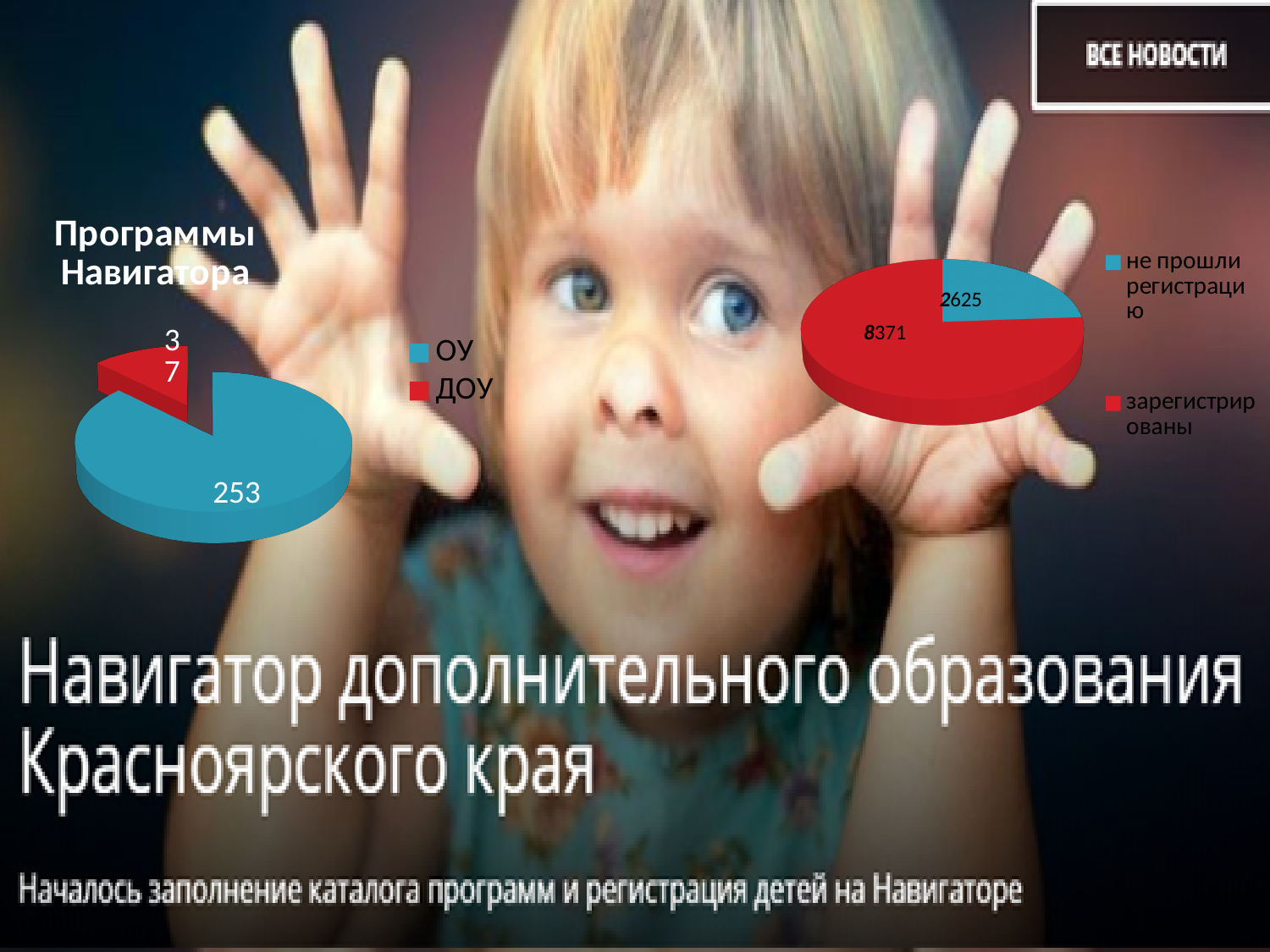
In the pie chart on the right of the slide, what colour is the 'зарегистрированы' slice? Red In the pie chart on the right of the slide, what is the value for 'зарегистрированы'? 8371 In the pie chart on the right of the slide, which category is larger: 'зарегистрированы' or 'не прошли регистрацию'? зарегистрированы In the 'Программы Навигатора' chart, which category has the smallest slice? ДОУ In the pie chart on the right of the slide, what is the total of the two slices? 10996 In the pie chart on the right of the slide, what is the difference between 'зарегистрированы' and 'не прошли регистрацию'? 5746 In the 'Программы Навигатора' chart, what is the value for ДОУ? 37 In the 'Программы Навигатора' chart, what is the value for ОУ? 253 What kind of chart is the 'Программы Навигатора' chart? Pie chart In the 'Программы Навигатора' chart, which category has the largest slice? ОУ How many categories does the legend of the 'Программы Навигатора' chart list? 2 In the pie chart on the right of the slide, what is the value for 'не прошли регистрацию'? 2625